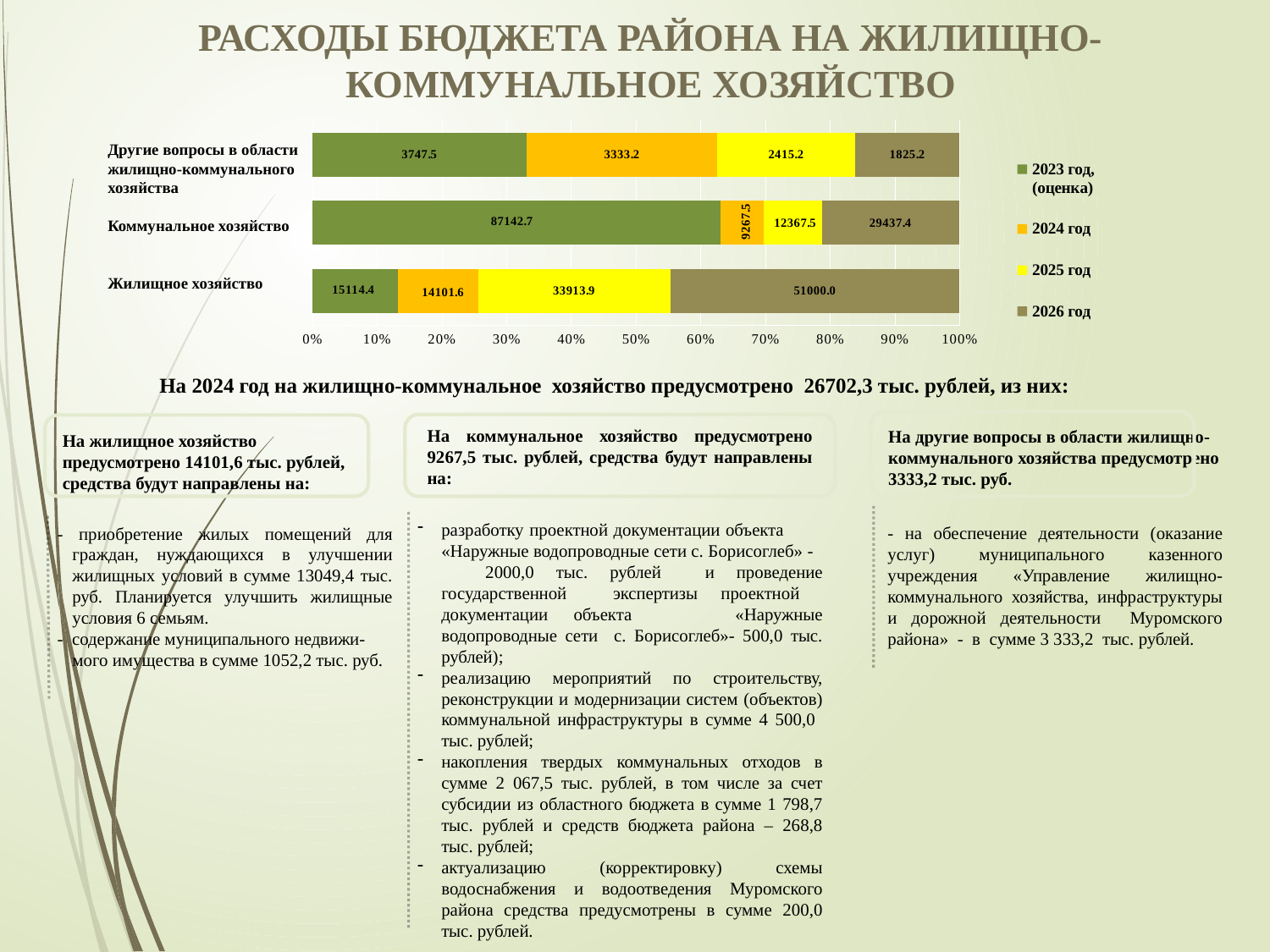
Which category has the highest value in the 2024 год series? Жилищное хозяйство What is the difference between the 2026 год and 2025 год values for Жилищное хозяйство? 17086.1 What is the value for Другие вопросы в области жилищно-коммунального хозяйства in the 2025 год series? 2415.2 What is the value for Жилищное хозяйство in the 2026 год series? 51000.0 Which category has the lowest value in the 2026 год series? Другие вопросы в области жилищно-коммунального хозяйства What is the value for Коммунальное хозяйство in the 2023 год (оценка) series? 87142.7 How many series does the legend list? 4 Which is larger for Коммунальное хозяйство: the 2025 год value or the 2024 год value? 2025 год What kind of chart is shown on the slide? Stacked bar chart What is the total of the stacked bar for Другие вопросы в области жилищно-коммунального хозяйства? 11321.1 How many categories are shown on the chart? 3 Do the values for Другие вопросы в области жилищно-коммунального хозяйства rise or fall from 2023 год to 2026 год? Fall